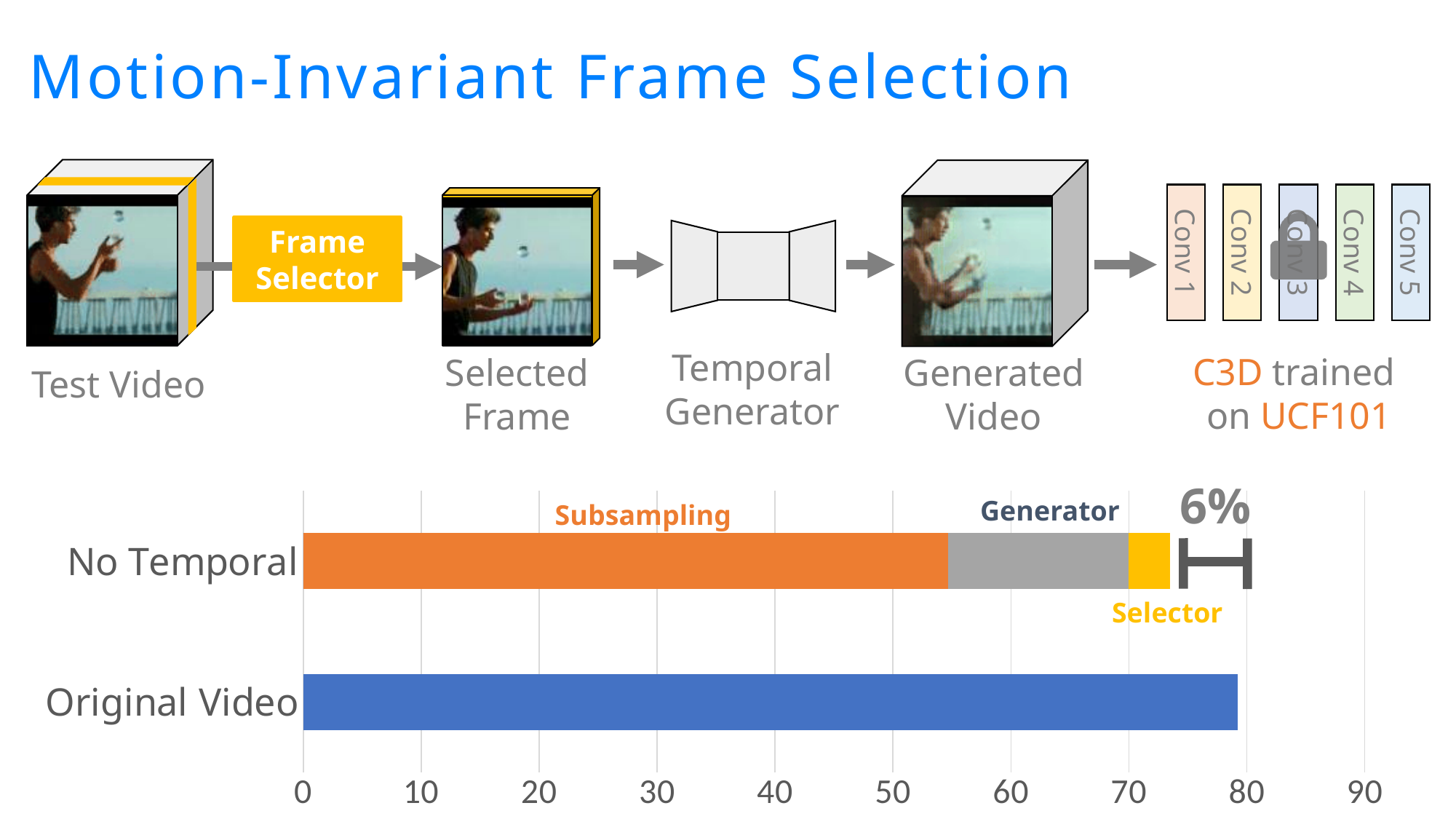
Is the total length of the No Temporal bar greater or less than 70? greater Is the Subsampling segment of the No Temporal bar greater or less than 60? less Which segment of the No Temporal bar is the smallest? Selector Is the Subsampling segment of the No Temporal bar greater or less than 50? greater What is the highest tick value shown on the horizontal axis of the bar chart? 90 What percentage gap is annotated between the No Temporal bar and the Original Video bar? 6% Which bar is longer, No Temporal or Original Video? Original Video What are the three labelled segments that make up the No Temporal bar? Subsampling, Generator, Selector How many categories are shown on the vertical axis of the bar chart? 2 Which segment of the No Temporal bar is the largest? Subsampling What kind of chart is shown at the bottom of the slide? bar chart